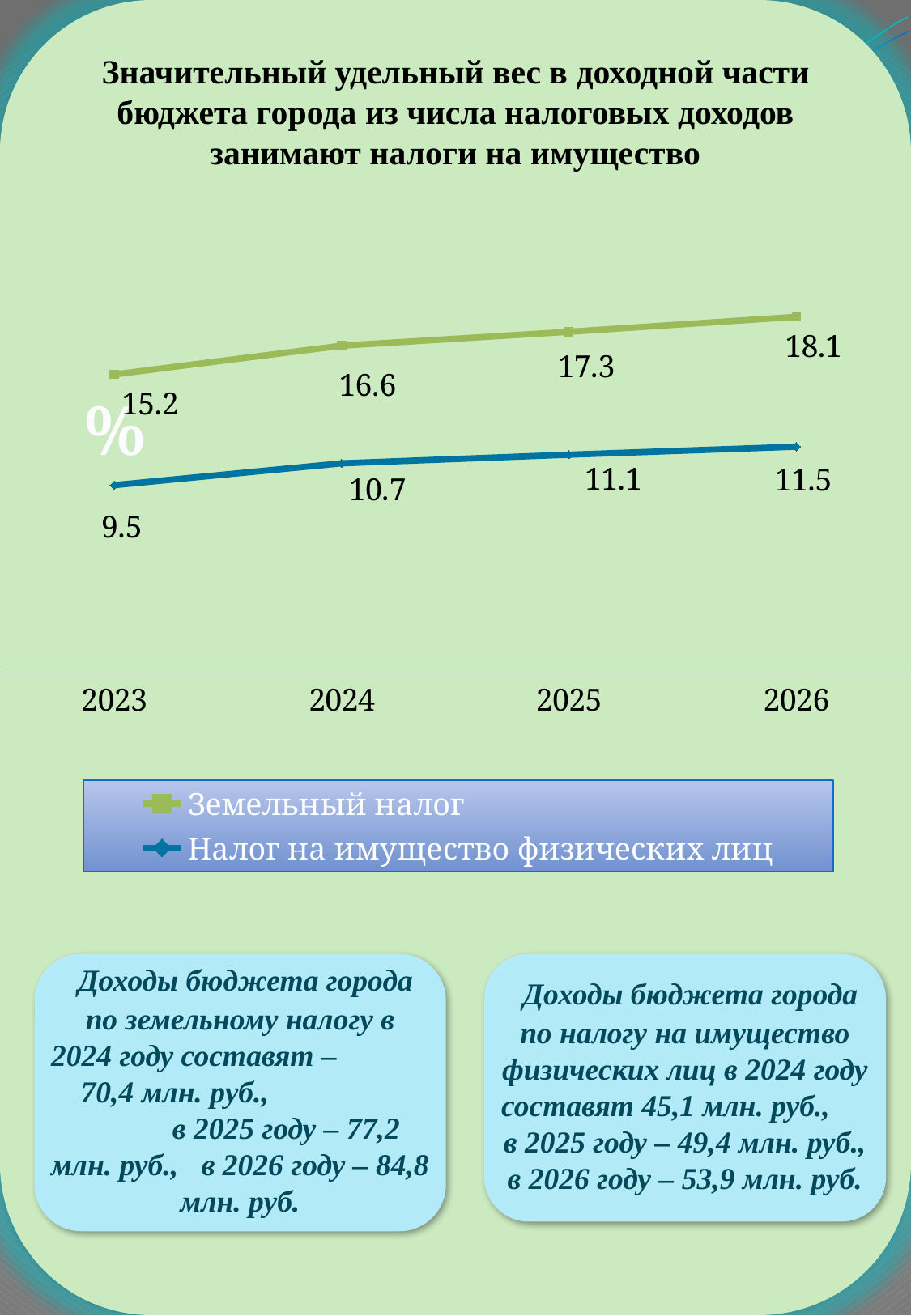
How many years are shown on the x axis? 4 Which series has the larger value in 2024, Земельный налог or Налог на имущество физических лиц? Земельный налог What is the difference between Земельный налог and Налог на имущество физических лиц in 2025? 6.2 In which year is Земельный налог highest? 2026 What is the value for Налог на имущество физических лиц in 2025? 11.1 In which year is Налог на имущество физических лиц lowest? 2023 What type of chart is shown on the slide? line chart How many series does the legend list? 2 What is the value for Земельный налог in 2026? 18.1 What is the value for Земельный налог in 2023? 15.2 What is the value for Налог на имущество физических лиц in 2024? 10.7 Do the values for Налог на имущество физических лиц rise or fall from 2023 to 2026? rise